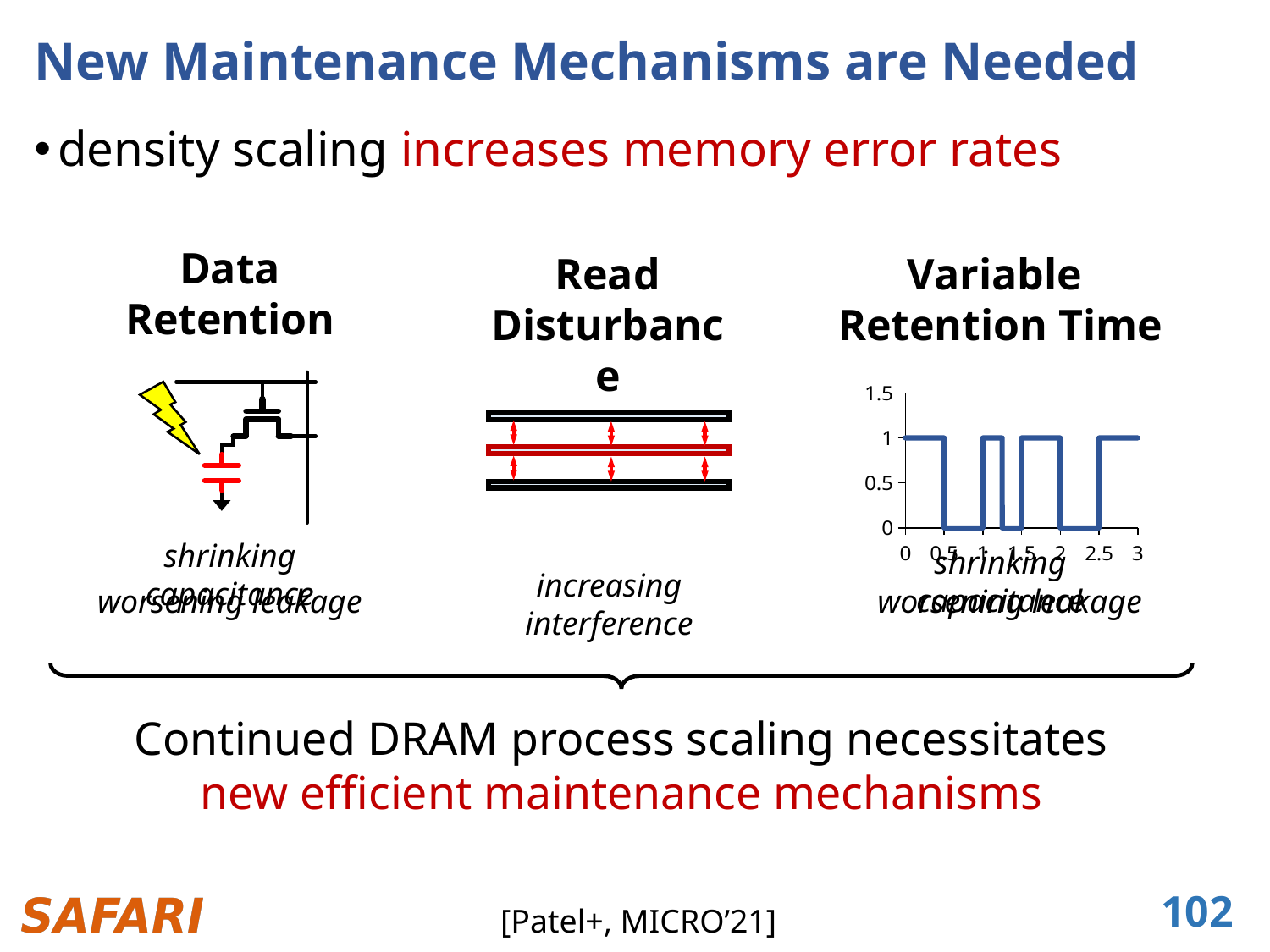
In the Variable Retention Time chart, does the line rise or fall between x = 0.25 and x = 0.75? fall In the Variable Retention Time chart, what is the largest value labelled on the x axis? 3 In the Variable Retention Time chart, how many tick labels are shown on the x axis? 7 What kind of chart is shown under the "Variable Retention Time" heading? line chart In the Variable Retention Time chart, what is the value of the line at x = 3? 1 In the Variable Retention Time chart, is the value of the line at x = 2.25 greater or less than 0.5? less In the Variable Retention Time chart, what is the value of the line at x = 0? 1 In the Variable Retention Time chart, is the value of the line at x = 2.75 greater or less than 0.5? greater In the Variable Retention Time chart, is the value of the line at x = 0.75 greater or less than 0.5? less In the Variable Retention Time chart, what is the highest value the line reaches? 1 In the Variable Retention Time chart, what is the lowest value the line reaches? 0 In the Variable Retention Time chart, what is the highest value labelled on the y axis? 1.5